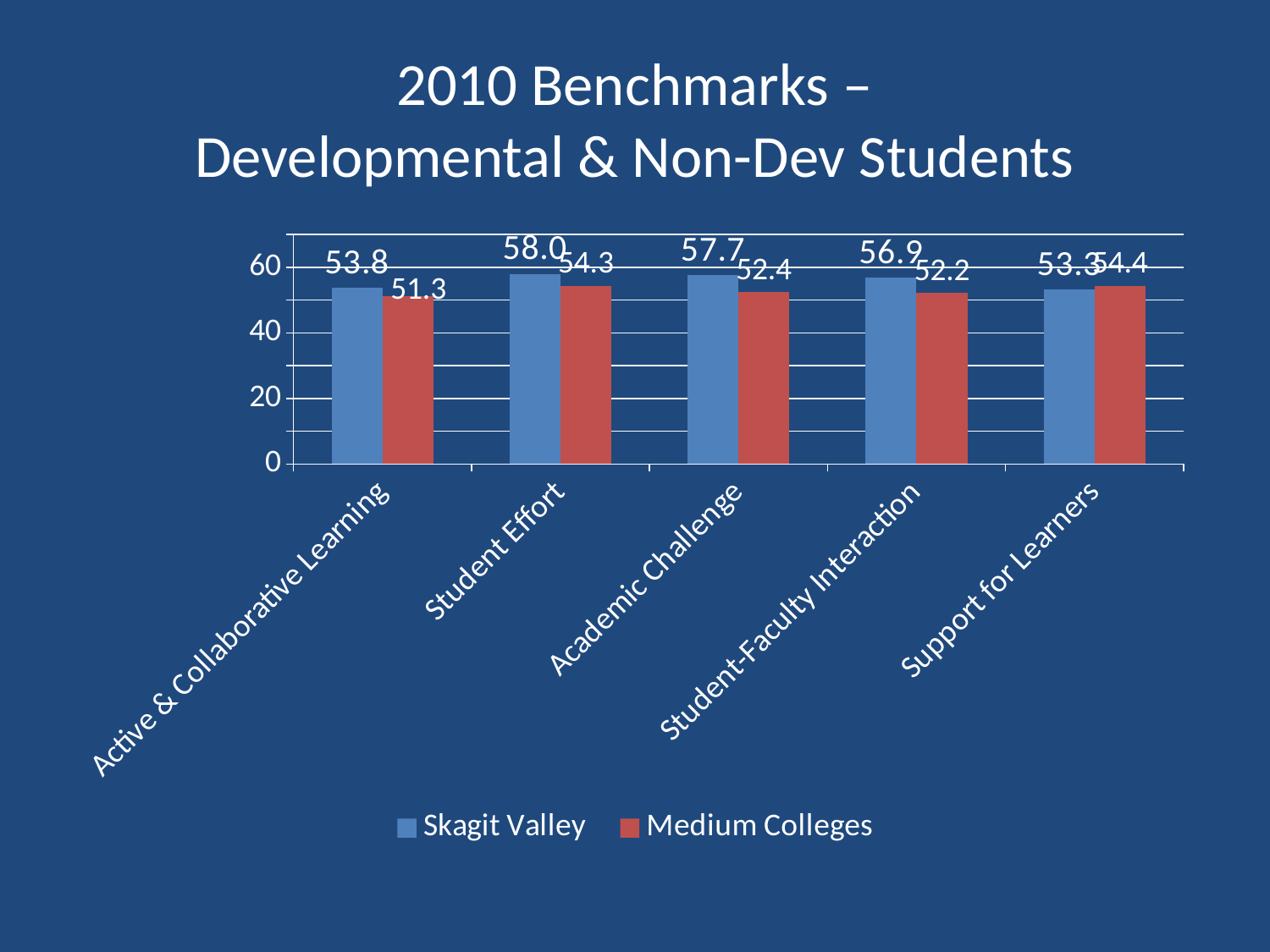
What is the Skagit Valley value for Student Effort? 58.0 What is the Medium Colleges value for Active & Collaborative Learning? 51.3 What kind of chart is shown on the slide? bar chart Which benchmark has the highest Skagit Valley value? Student Effort How many series does the legend list? 2 Is the Skagit Valley value for Academic Challenge greater or less than 40? greater What is the difference between the Skagit Valley and Medium Colleges values for Academic Challenge? 5.3 Which benchmark has the lowest Medium Colleges value? Active & Collaborative Learning How many benchmark categories are shown on the x axis? 5 What is the Skagit Valley value for Student-Faculty Interaction? 56.9 For Academic Challenge, which is larger: Skagit Valley or Medium Colleges? Skagit Valley What is the difference between the Skagit Valley and Medium Colleges values for Student Effort? 3.7